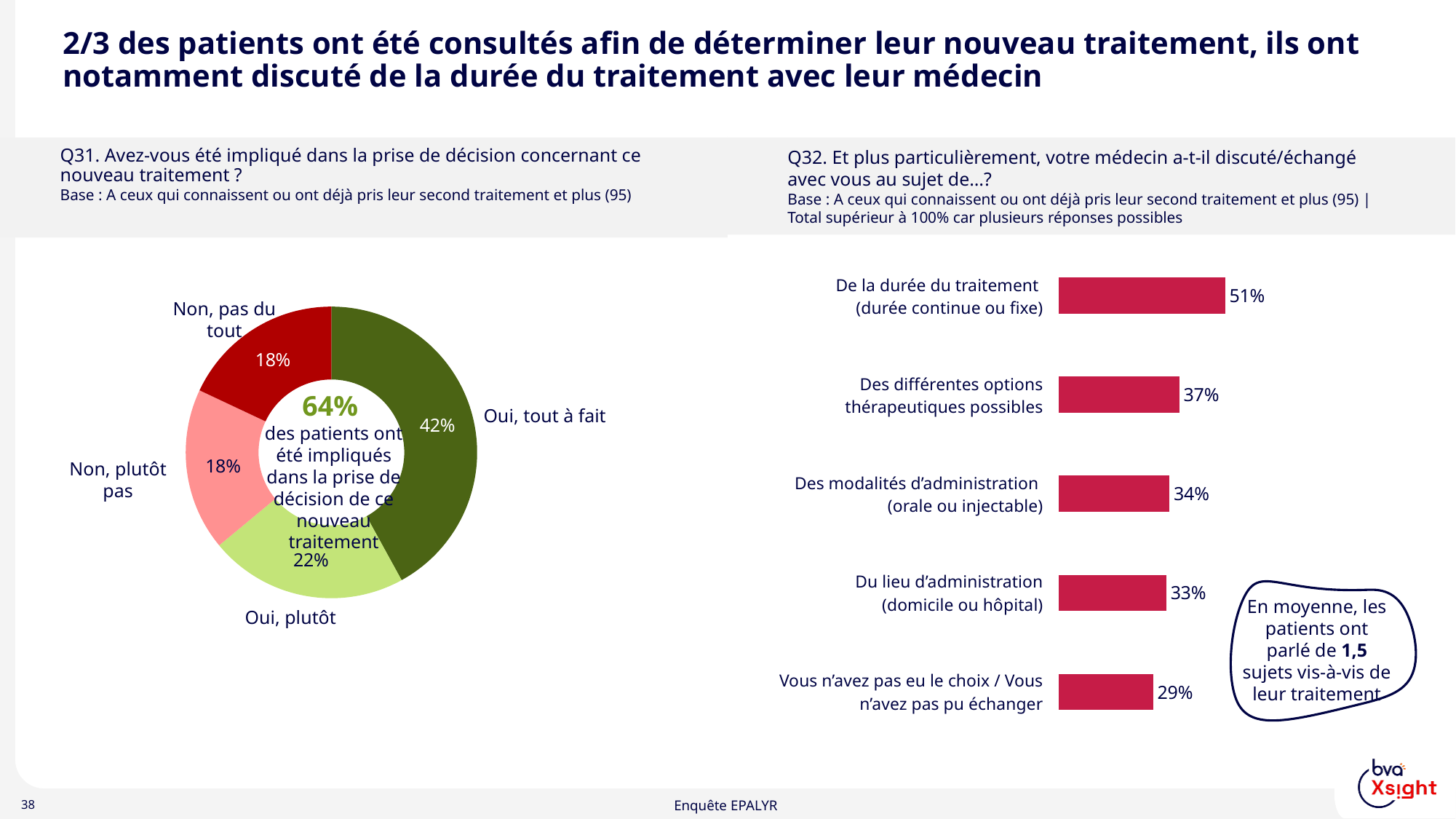
In the Q32 bar chart on the right, what percentage of patients discussed "De la durée du traitement (durée continue ou fixe)" with their doctor? 51% In the Q31 donut chart on the left, what share of patients answered "Oui, plutôt"? 22% In the Q32 bar chart on the right, what is the difference in percentage points between "De la durée du traitement" and "Des différentes options thérapeutiques possibles"? 14 percentage points In the Q31 donut chart on the left, how many slices does the donut have? 4 In the Q31 donut chart on the left, what share of patients answered "Oui, tout à fait"? 42% In the Q31 donut chart on the left, what is the difference in percentage points between "Oui, tout à fait" and "Oui, plutôt"? 20 percentage points In the Q31 donut chart on the left, which answer has the largest share? Oui, tout à fait In the Q32 bar chart on the right, how many bars are there? 5 In the Q32 bar chart on the right, what percentage is shown for "Du lieu d'administration (domicile ou hôpital)"? 33% In the Q32 bar chart on the right, which topic has the lowest percentage? Vous n'avez pas eu le choix / Vous n'avez pas pu échanger What type of chart is shown on the right side of the slide for Q32? Bar chart In the Q31 donut chart on the left, what percentage is shown in the centre of the donut? 64%